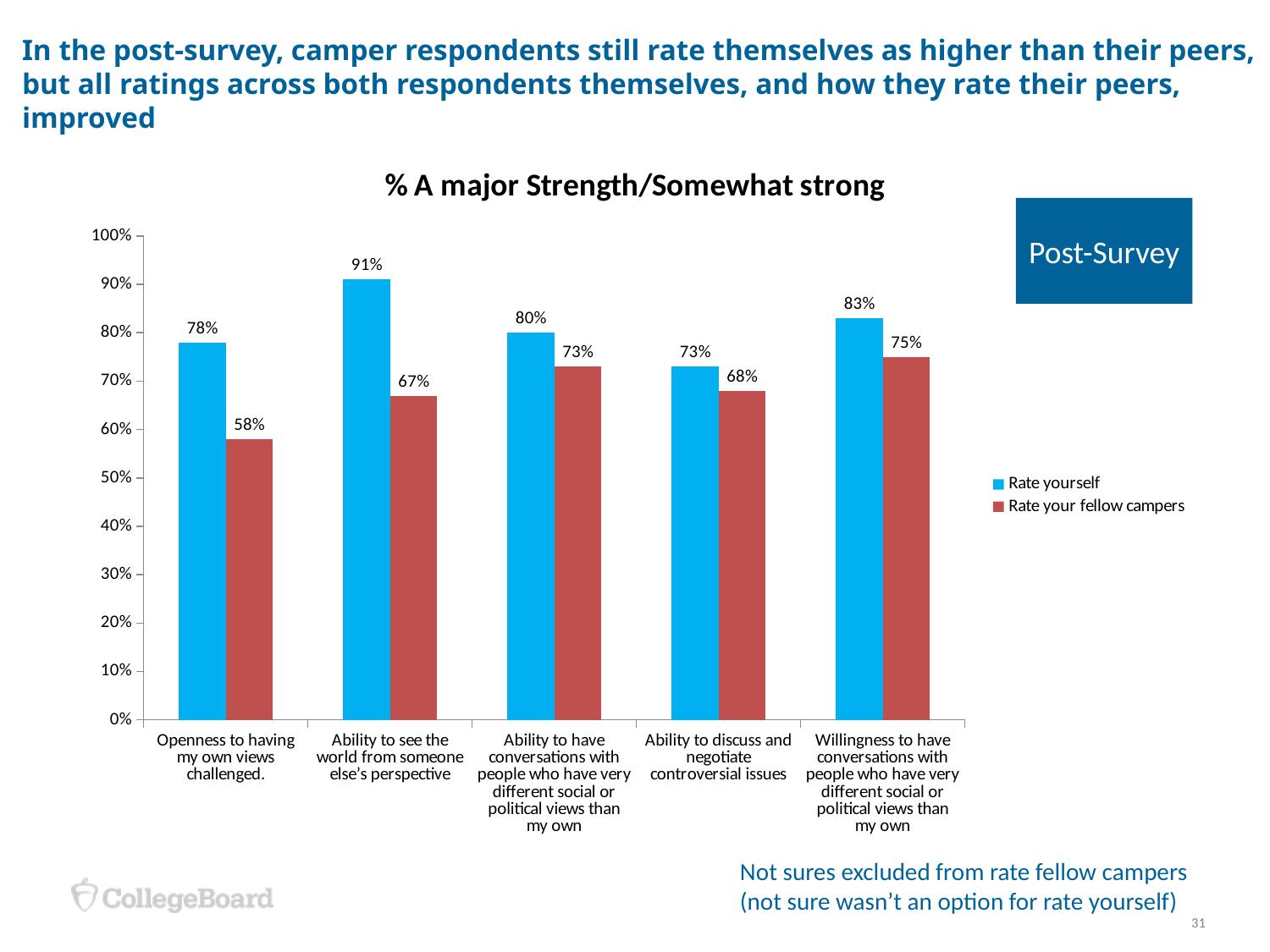
Which series is shown in red? Rate your fellow campers Which is larger: the 'Rate yourself' value for 'Willingness to have conversations with people who have very different social or political views than my own' or the 'Rate yourself' value for 'Ability to discuss and negotiate controversial issues'? Willingness to have conversations with people who have very different social or political views than my own What is the 'Rate your fellow campers' value for 'Openness to having my own views challenged.'? 58% What is the 'Rate your fellow campers' value for 'Ability to discuss and negotiate controversial issues'? 68% How many series does the legend list? 2 What is the difference between the 'Rate yourself' and 'Rate your fellow campers' values for 'Ability to see the world from someone else's perspective'? 24% What is the 'Rate yourself' value for 'Ability to see the world from someone else's perspective'? 91% Which category has the highest 'Rate yourself' value? Ability to see the world from someone else's perspective What kind of chart is shown on the slide? Bar chart Which category has the lowest 'Rate your fellow campers' value? Openness to having my own views challenged. How many categories are shown on the x axis? 5 What is the title of the chart? % A major Strength/Somewhat strong